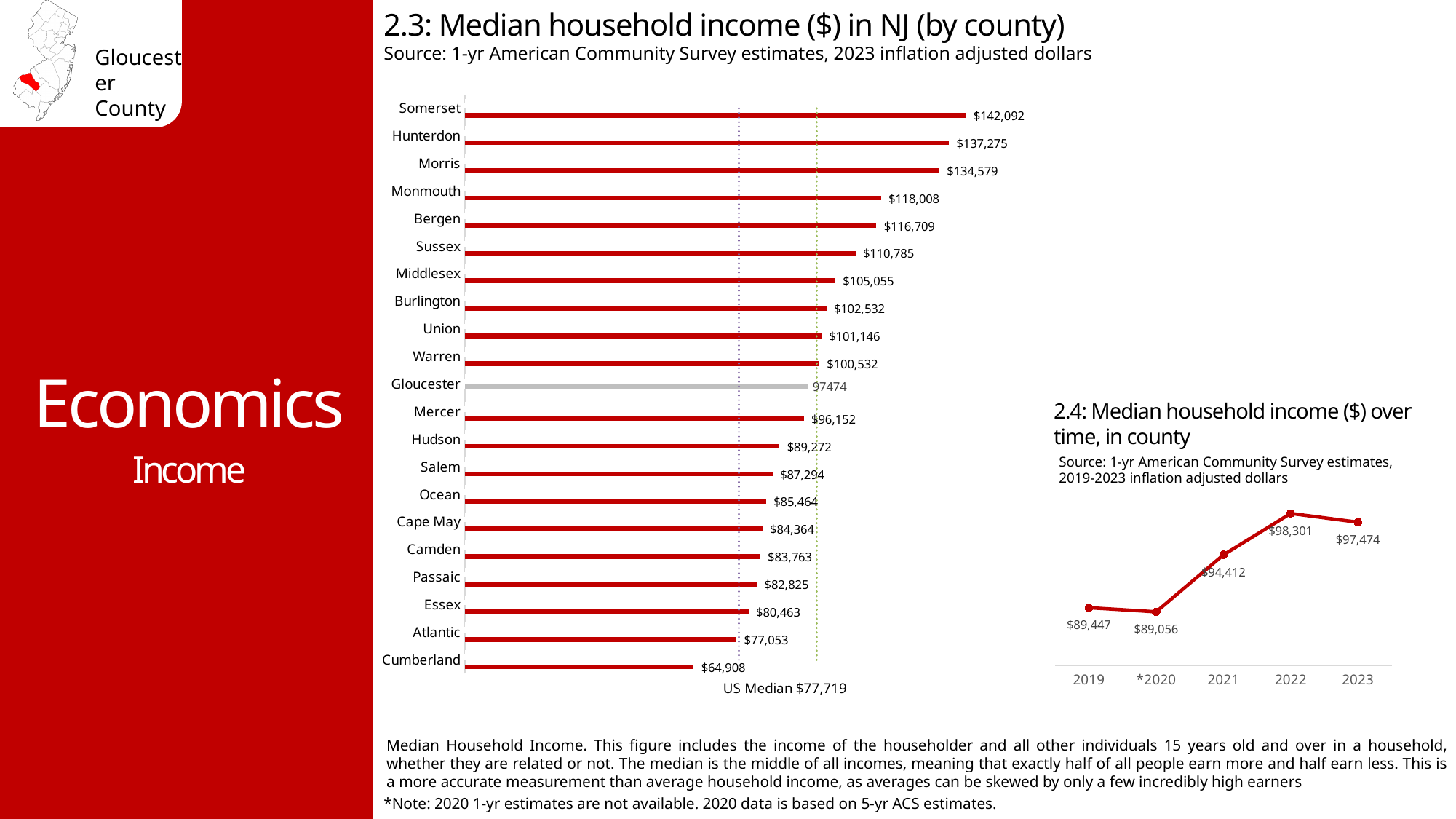
In the chart '2.3: Median household income ($) in NJ (by county)', what is the value for Somerset? $142,092 How many counties are shown in the chart '2.3: Median household income ($) in NJ (by county)'? 21 In the chart '2.4: Median household income ($) over time, in county', what is the difference between the 2022 and 2019 values? $8,854 In the chart '2.3: Median household income ($) in NJ (by county)', which is larger, the value for Bergen or the value for Sussex? Bergen In the chart '2.3: Median household income ($) in NJ (by county)', what is the difference between Somerset and Cumberland? $77,184 In the chart '2.3: Median household income ($) in NJ (by county)', what is the value for Gloucester? 97474 In the chart '2.3: Median household income ($) in NJ (by county)', which county has the lowest median household income? Cumberland In the chart '2.4: Median household income ($) over time, in county', what is the value for 2022? $98,301 What kind of chart is '2.4: Median household income ($) over time, in county'? Line chart In the chart '2.4: Median household income ($) over time, in county', which year has the lowest value? *2020 In the chart '2.3: Median household income ($) in NJ (by county)', which county has the highest median household income? Somerset What kind of chart is '2.3: Median household income ($) in NJ (by county)'? Bar chart